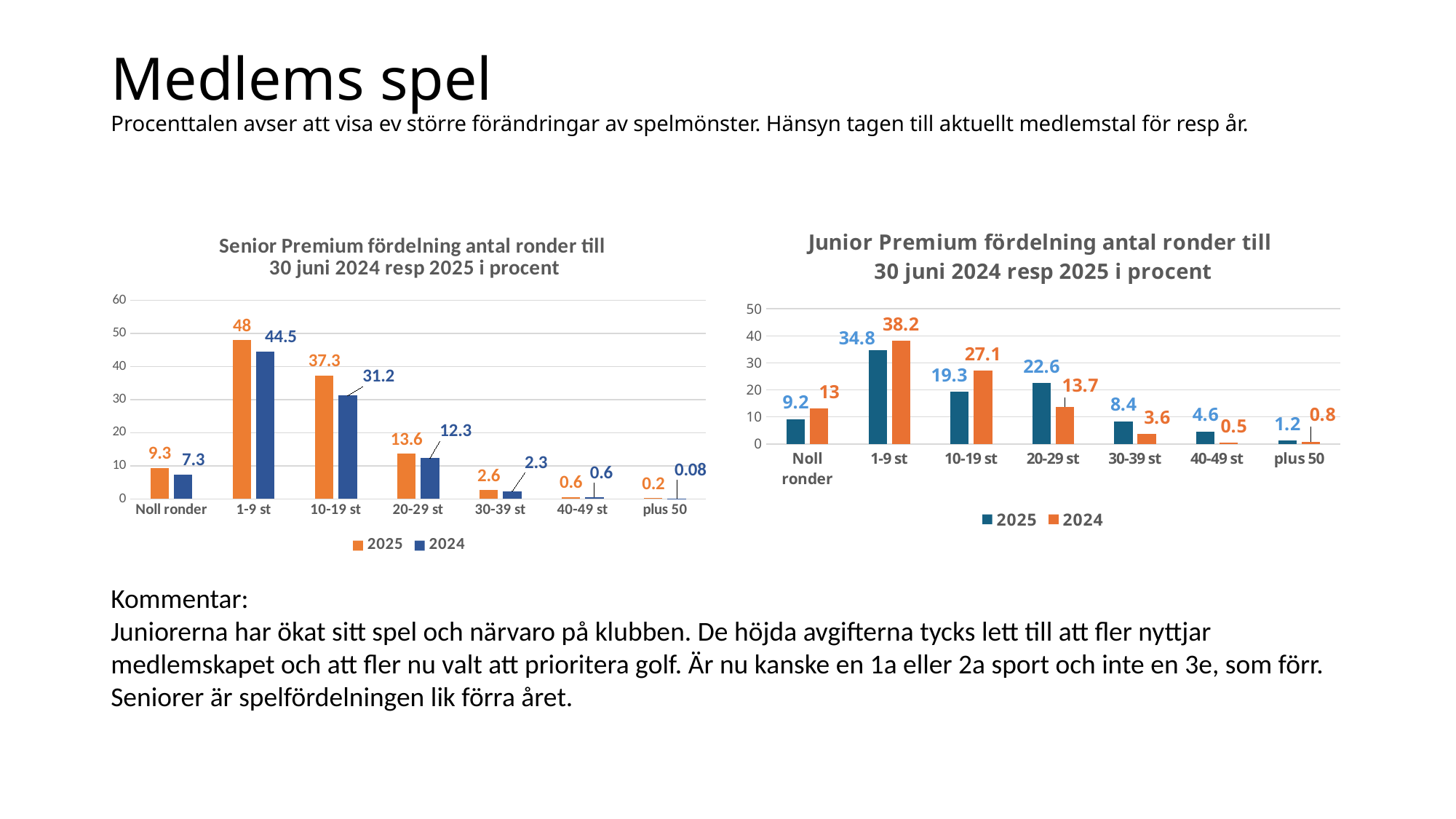
In the Senior Premium chart, what is the 2025 value for 1-9 st? 48 How many series does the legend of the Junior Premium chart list? 2 What kind of chart is the Senior Premium chart? Bar chart In the Junior Premium chart, which is larger for 30-39 st: the 2025 value or the 2024 value? 2025 In the Senior Premium chart, which category has the lowest 2024 value? plus 50 In the Senior Premium chart, what is the 2024 value for 10-19 st? 31.2 In the Junior Premium chart, what is the difference between the 2024 and 2025 values for 10-19 st? 7.8 In the Senior Premium chart, what is the difference between the 2025 and 2024 values for 1-9 st? 3.5 How many categories are shown on the x axis of the Senior Premium chart? 7 In the Junior Premium chart, which category has the highest 2025 value? 1-9 st In the Junior Premium chart, what is the 2025 value for 20-29 st? 22.6 In the Junior Premium chart, what is the 2024 value for Noll ronder? 13